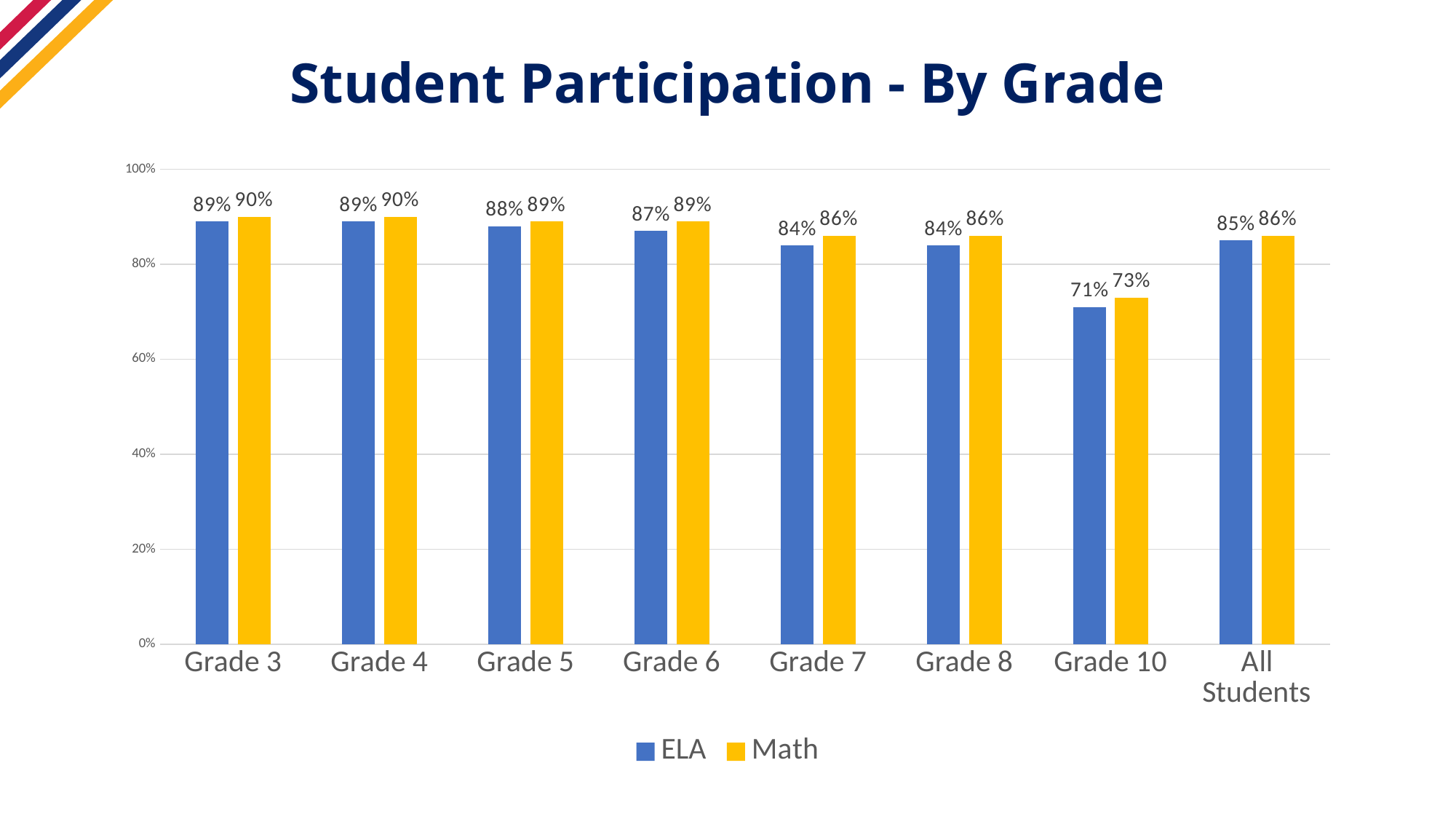
What kind of chart is shown on the slide? Bar chart How many series does the legend list? 2 What is the difference between the ELA participation rates for Grade 3 and Grade 10? 18% Which grade has the lowest ELA participation rate? Grade 10 What is the Math participation rate for Grade 10? 73% How many categories are shown on the x axis? 8 What is the ELA participation rate for All Students? 85% What is the difference between the Math and ELA participation rates for Grade 7? 2% Which is larger, the Math rate for Grade 5 or the Math rate for Grade 8? Math rate for Grade 5 What is the ELA participation rate for Grade 6? 87% Which category has the lowest Math participation rate? Grade 10 Is the ELA participation rate for Grade 10 greater or less than 80%? less